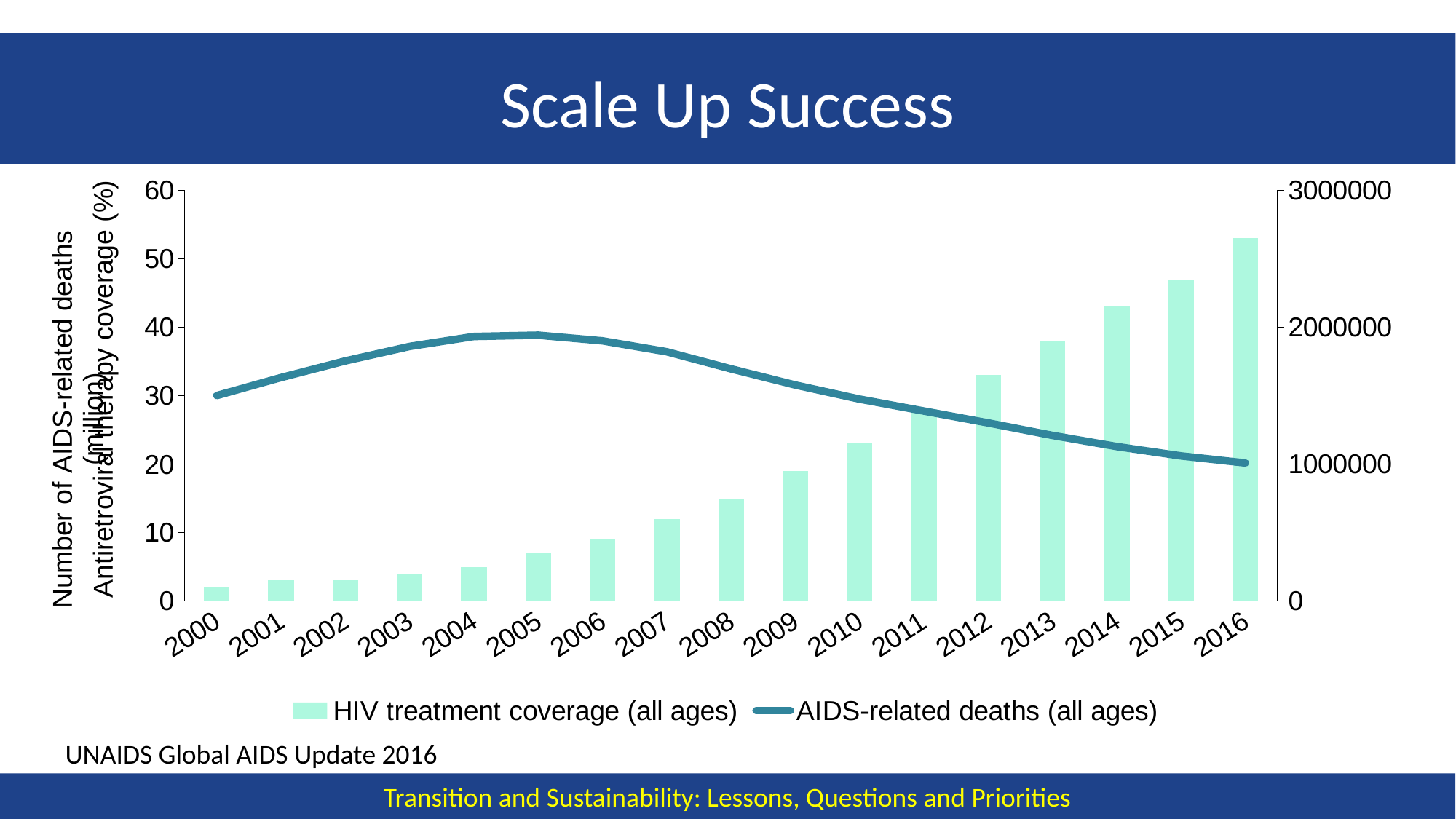
Is the HIV treatment coverage for 2016 greater or less than 50? greater How many years are shown on the x axis? 17 Does the AIDS-related deaths line rise or fall from 2005 to 2016? fall Which is larger, the HIV treatment coverage in 2012 or in 2009? 2012 Which year has the lowest number of AIDS-related deaths (all ages)? 2016 How many series does the legend list? 2 Do the HIV treatment coverage bars rise or fall from 2000 to 2016? rise Which year has the highest HIV treatment coverage (all ages)? 2016 Is the HIV treatment coverage for 2008 greater or less than 20? less What kind of chart is shown on the slide? A combined bar and line chart Is the number of AIDS-related deaths in 2005 greater or less than 1000000? greater Which year has the lowest HIV treatment coverage (all ages)? 2000